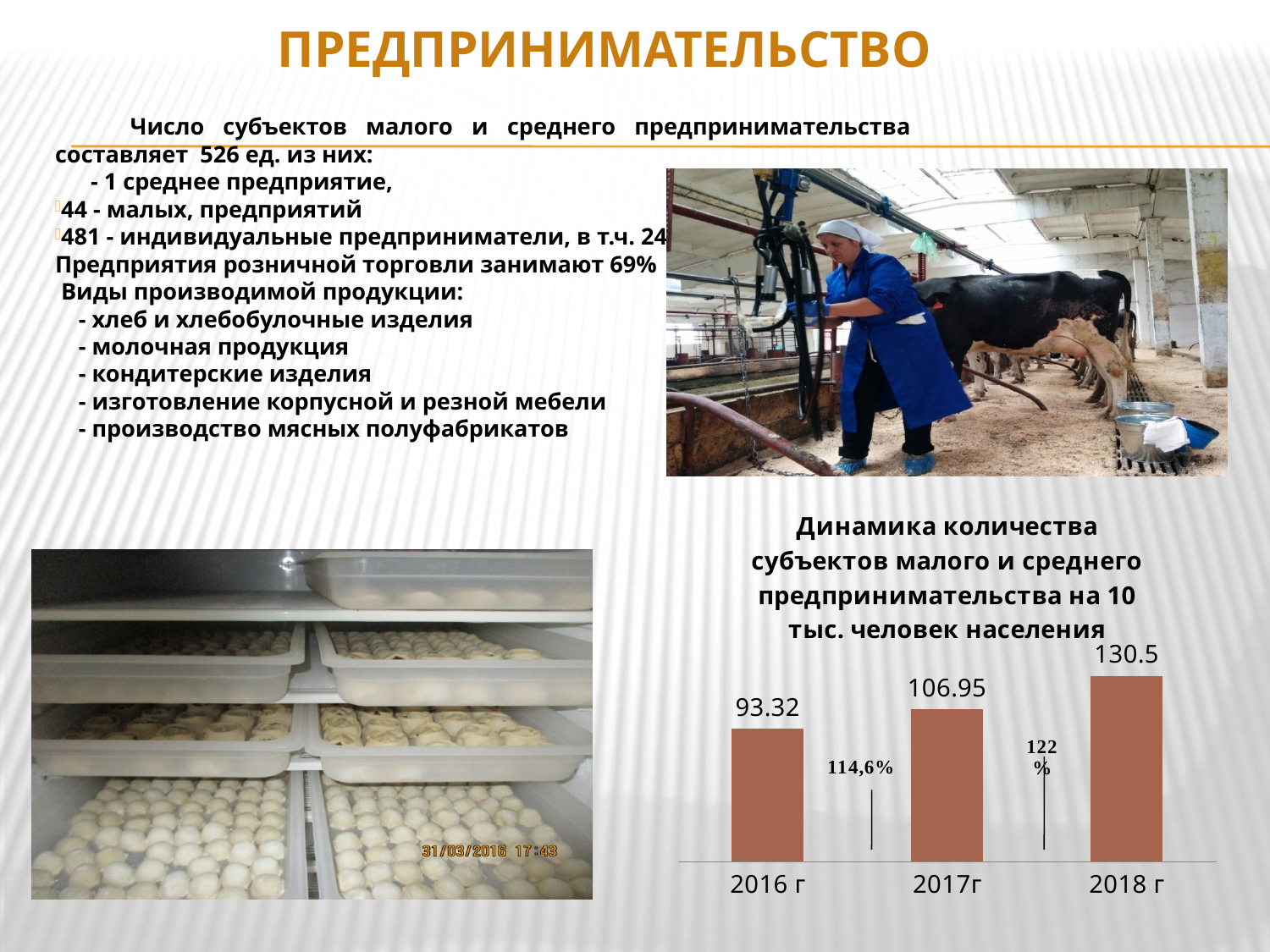
Which year has the highest value in the chart? 2018 г What kind of chart is shown on the slide? bar chart Do the values rise or fall from 2016 г to 2018 г? rise Which year has the lowest value in the chart? 2016 г What is the value for 2017г in the chart? 106.95 What is the value for 2016 г in the chart? 93.32 Which is larger, the value for 2017г or the value for 2018 г? 2018 г What is the value for 2018 г in the chart? 130.5 What growth percentage is shown between the 2016 г and 2017г bars? 114,6% What is the difference between the values for 2017г and 2016 г? 13.63 What is the difference between the values for 2018 г and 2016 г? 37.18 How many years are shown in the chart? 3